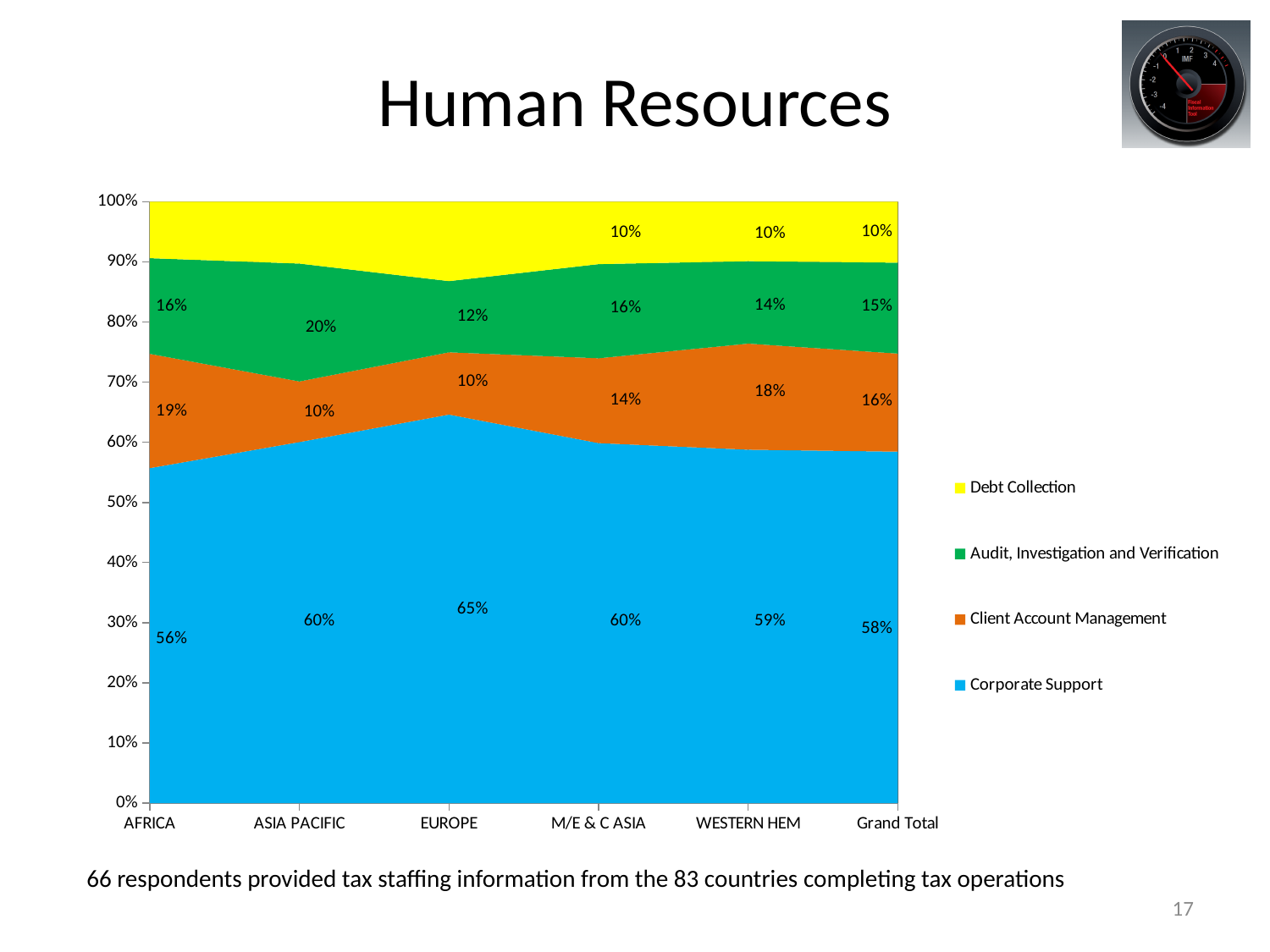
Which is larger, the Audit, Investigation and Verification share for EUROPE or for M/E & C ASIA? M/E & C ASIA What is the Corporate Support share for EUROPE? 65% Which category has the highest Corporate Support share? EUROPE What is the Audit, Investigation and Verification share for ASIA PACIFIC? 20% Which series is shown in yellow? Debt Collection How many series does the legend list? 4 What is the difference between the Client Account Management share for WESTERN HEM and for ASIA PACIFIC? 8% What is the Client Account Management share for AFRICA? 19% Which category has the lowest Corporate Support share? AFRICA How many categories are shown along the x axis? 6 What is the Debt Collection share for the Grand Total? 10% What kind of chart is shown on the slide? Stacked area chart